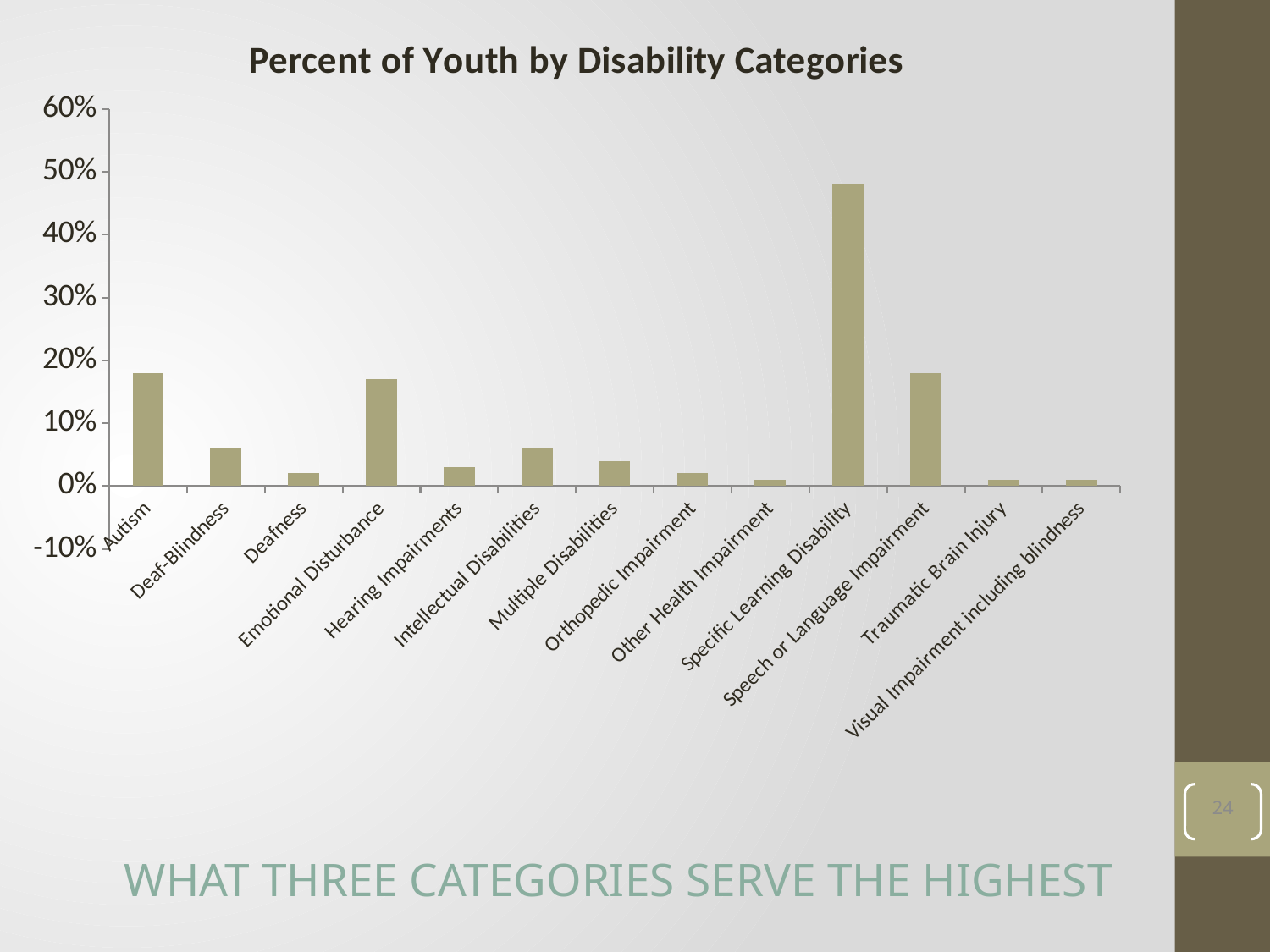
Which is larger, the value for Specific Learning Disability or the value for Autism? Specific Learning Disability Which is larger, the value for Deaf-Blindness or the value for Deafness? Deaf-Blindness What is the highest value shown on the vertical axis? 60% What is the title of the chart? Percent of Youth by Disability Categories Is the value for Specific Learning Disability greater or less than 40%? greater What kind of chart is shown on the slide? bar chart Is the value for Autism greater or less than 20%? less Is the value for Speech or Language Impairment greater or less than 10%? greater Which disability category has the highest percent of youth? Specific Learning Disability How many disability categories are plotted on the x axis? 13